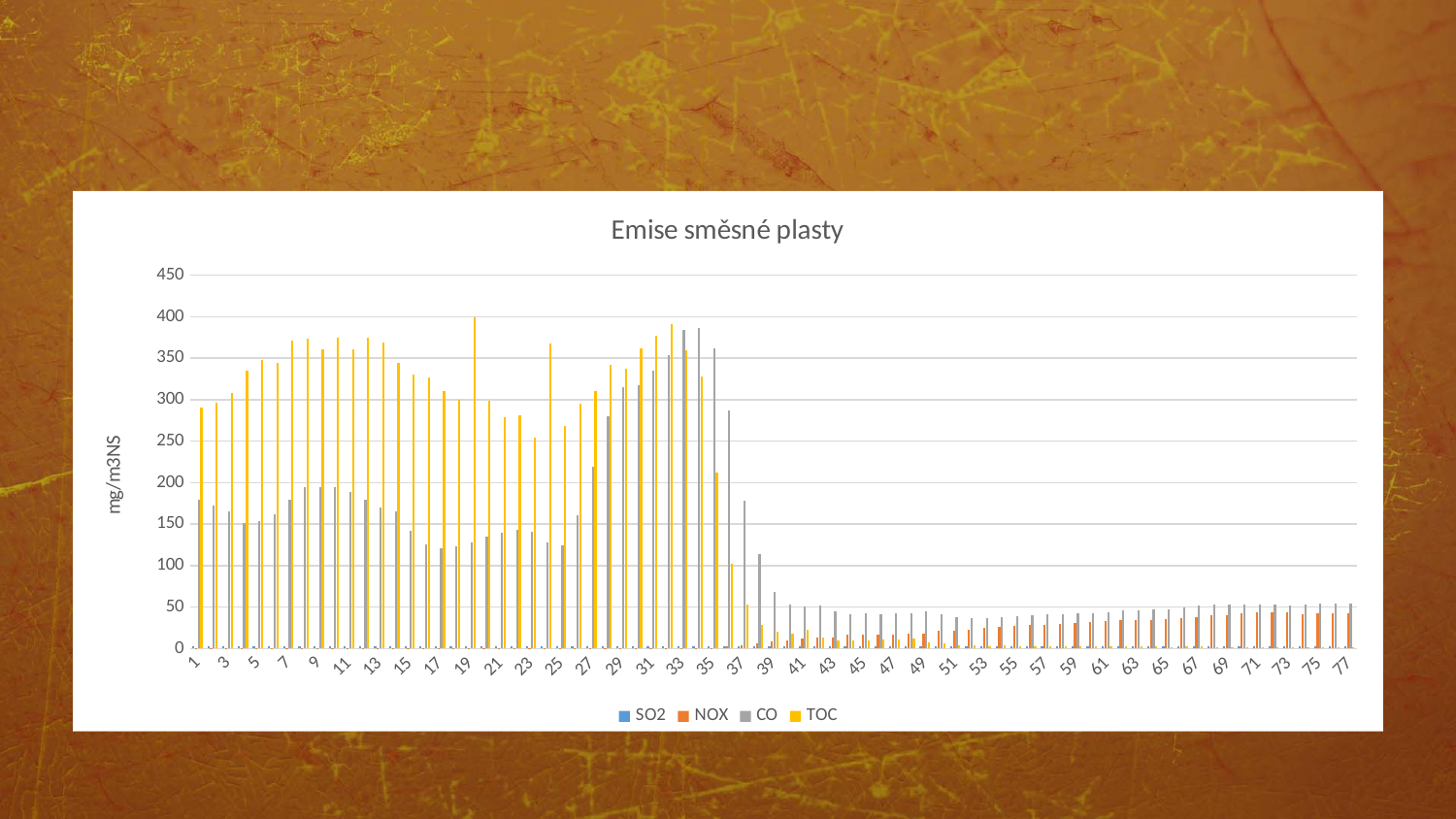
Is the CO value for category 37 greater or less than 250? less What kind of chart is shown on the slide? bar chart Is the TOC value for category 39 greater or less than 50? less How many categories are plotted along the x axis? 77 At category 1, which is larger, the CO value or the TOC value? TOC Is the CO value for category 33 greater or less than 350? greater What is the label on the vertical axis? mg/m3NS How many series does the legend list? 4 Are the TOC values for categories 39 to 77 higher or lower than the TOC values for categories 1 to 35? lower What is the title of the chart? Emise směsné plasty